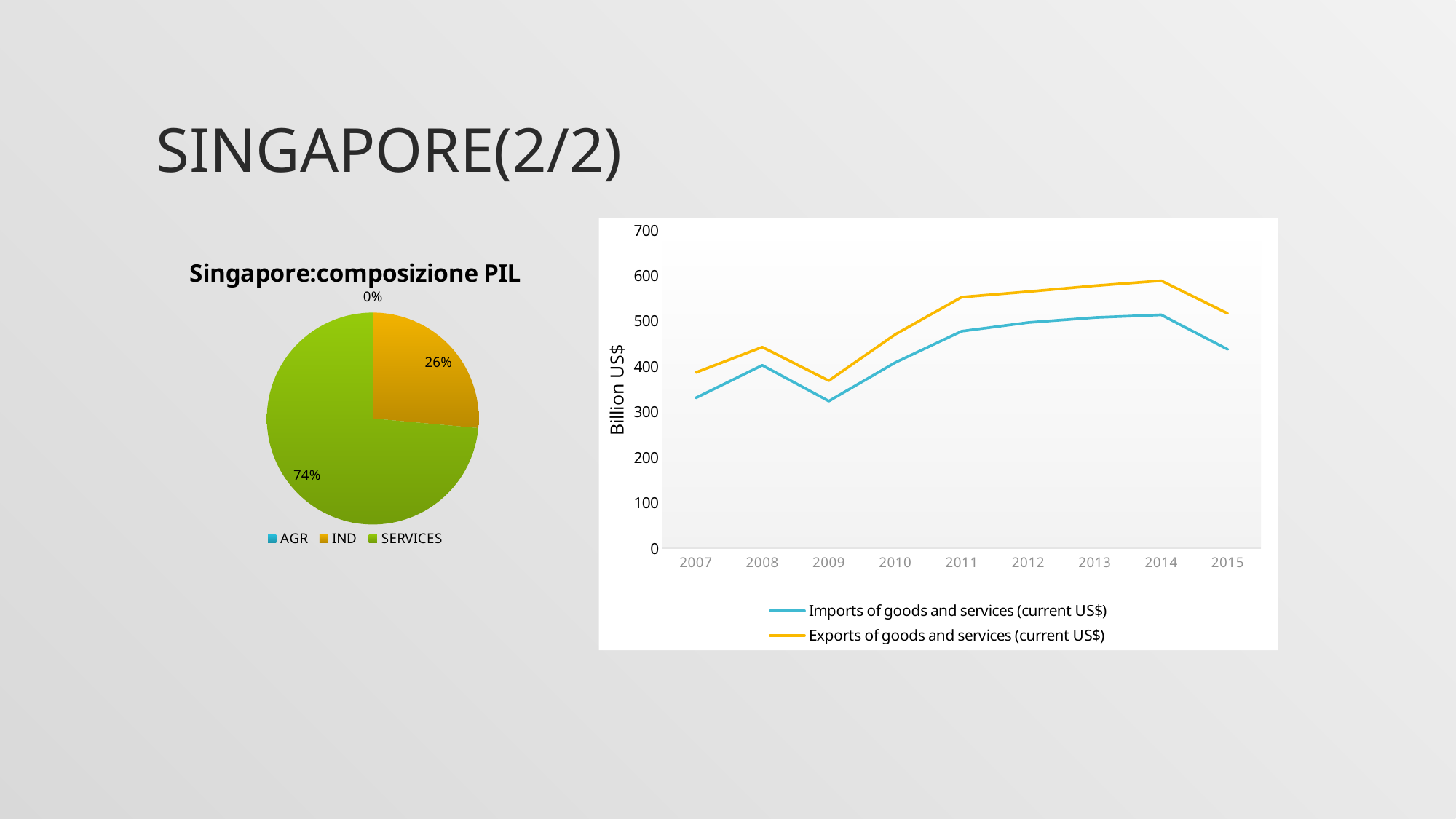
In the line chart on the right, is the value for Imports of goods and services in 2009 greater or less than 400? less In the pie chart 'Singapore:composizione PIL', what is the difference between the SERVICES share and the IND share? 48% In the pie chart 'Singapore:composizione PIL', what share does IND have? 26% In the line chart on the right, is the value for Exports of goods and services in 2014 greater or less than 500? greater How many series does the legend of the line chart on the right list? 2 In the pie chart 'Singapore:composizione PIL', what share does SERVICES have? 74% How many categories does the legend of the pie chart 'Singapore:composizione PIL' list? 3 In the pie chart 'Singapore:composizione PIL', which category has the smallest share? AGR In the pie chart 'Singapore:composizione PIL', which category has the largest share? SERVICES In the line chart on the right, which series is higher in 2011, Imports or Exports of goods and services? Exports of goods and services (current US$) What kind of chart is the chart on the right of the slide? Line chart In the pie chart 'Singapore:composizione PIL', what share does AGR have? 0%